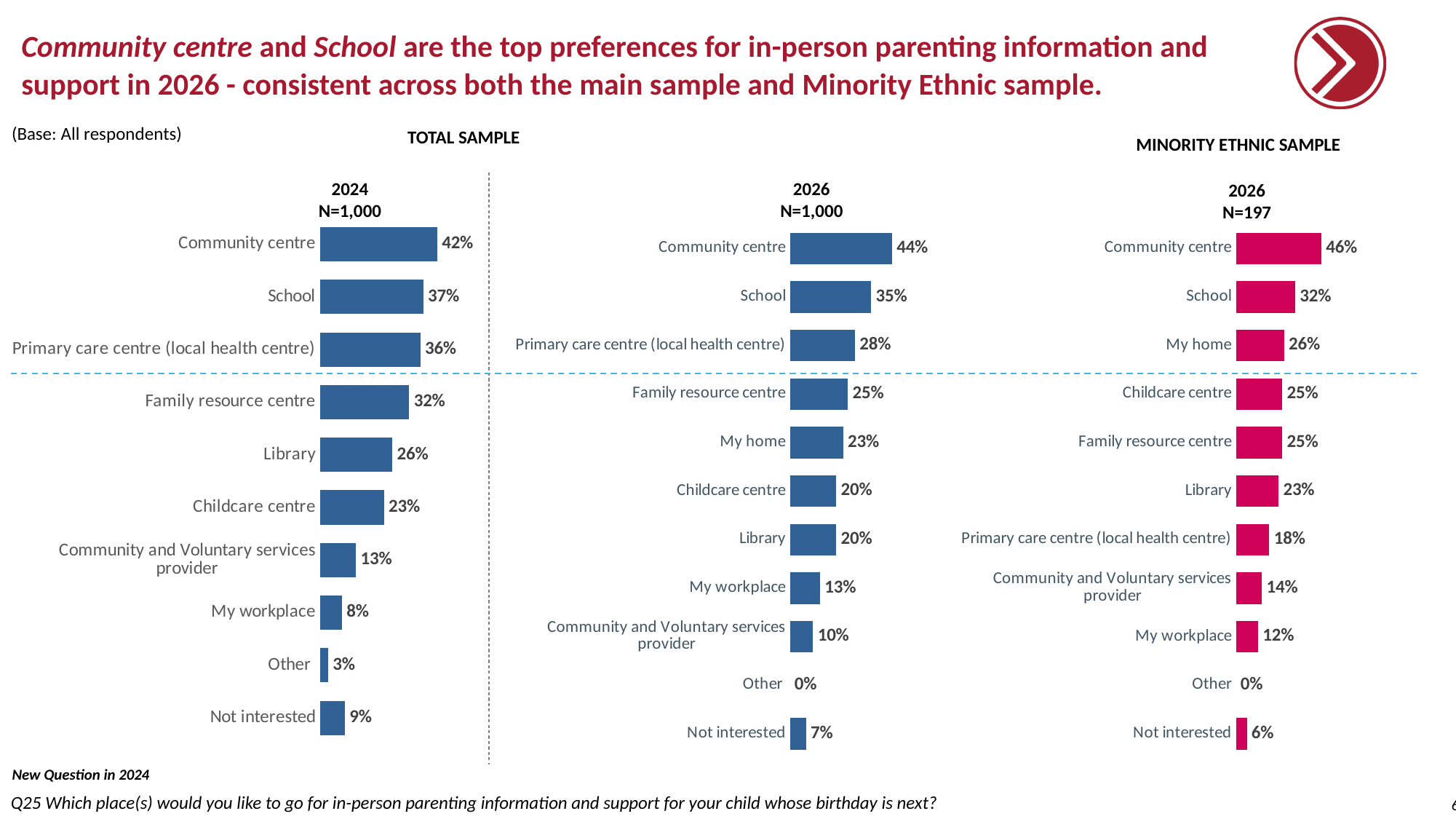
In the Total Sample 2024 chart, which category has the lowest value? Other In the Minority Ethnic Sample 2026 chart, what percentage is shown for My home? 26% In the Minority Ethnic Sample 2026 chart, what is the difference between Library and My workplace? 11% What colour are the bars in the Minority Ethnic Sample 2026 chart? Pink/magenta In the Total Sample 2026 chart, what is the difference between Community centre and School? 9% Which is larger in the Total Sample 2024 chart: Library or Childcare centre? Library How many categories are shown in the Total Sample 2026 chart? 11 In the Minority Ethnic Sample 2026 chart, which category has the highest value? Community centre In the Total Sample 2026 chart, what percentage is shown for Primary care centre (local health centre)? 28% What is the sample size (N) shown for the Minority Ethnic Sample 2026 chart? N=197 In the Total Sample 2024 chart, what percentage is shown for Community centre? 42% What kind of chart is the Minority Ethnic Sample 2026 chart? Bar chart